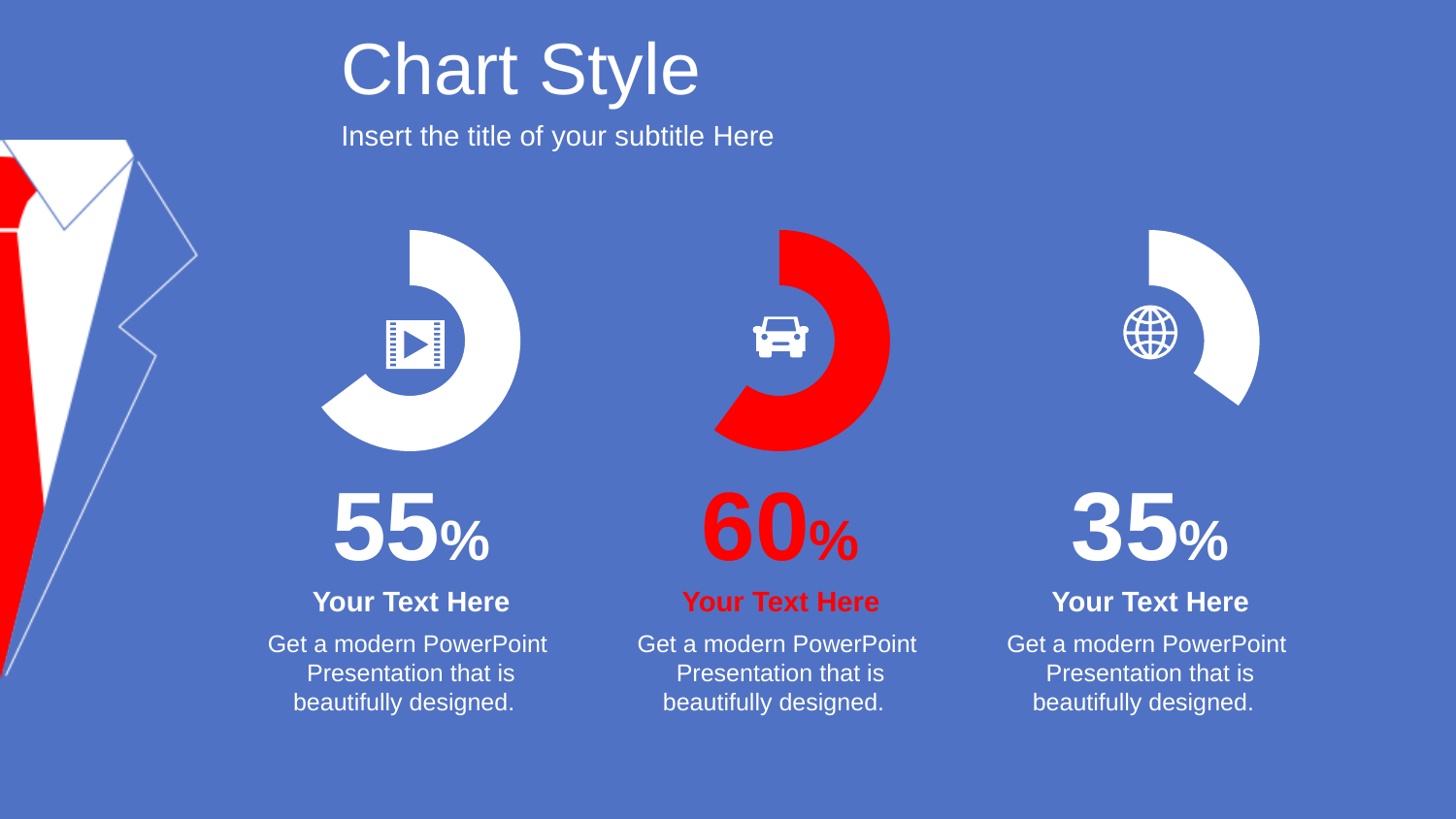
Which of the three charts shows the highest percentage: left, middle, or right? middle What percentage is shown for the left chart (with the film icon)? 55% What colour is the filled ring of the middle chart? red What is the difference between the percentage in the middle chart and the percentage in the left chart? 5% What kind of chart is used for each of the three percentages on the slide? donut chart What percentage is shown for the right chart (with the globe icon)? 35% What is the difference between the percentage in the middle chart and the percentage in the right chart? 25% Is the percentage in the left chart or the right chart larger? left How many donut charts are shown on the slide? 3 What percentage is shown for the middle chart (with the car icon)? 60% What is the title of the slide? Chart Style Which of the three charts shows the lowest percentage: left, middle, or right? right